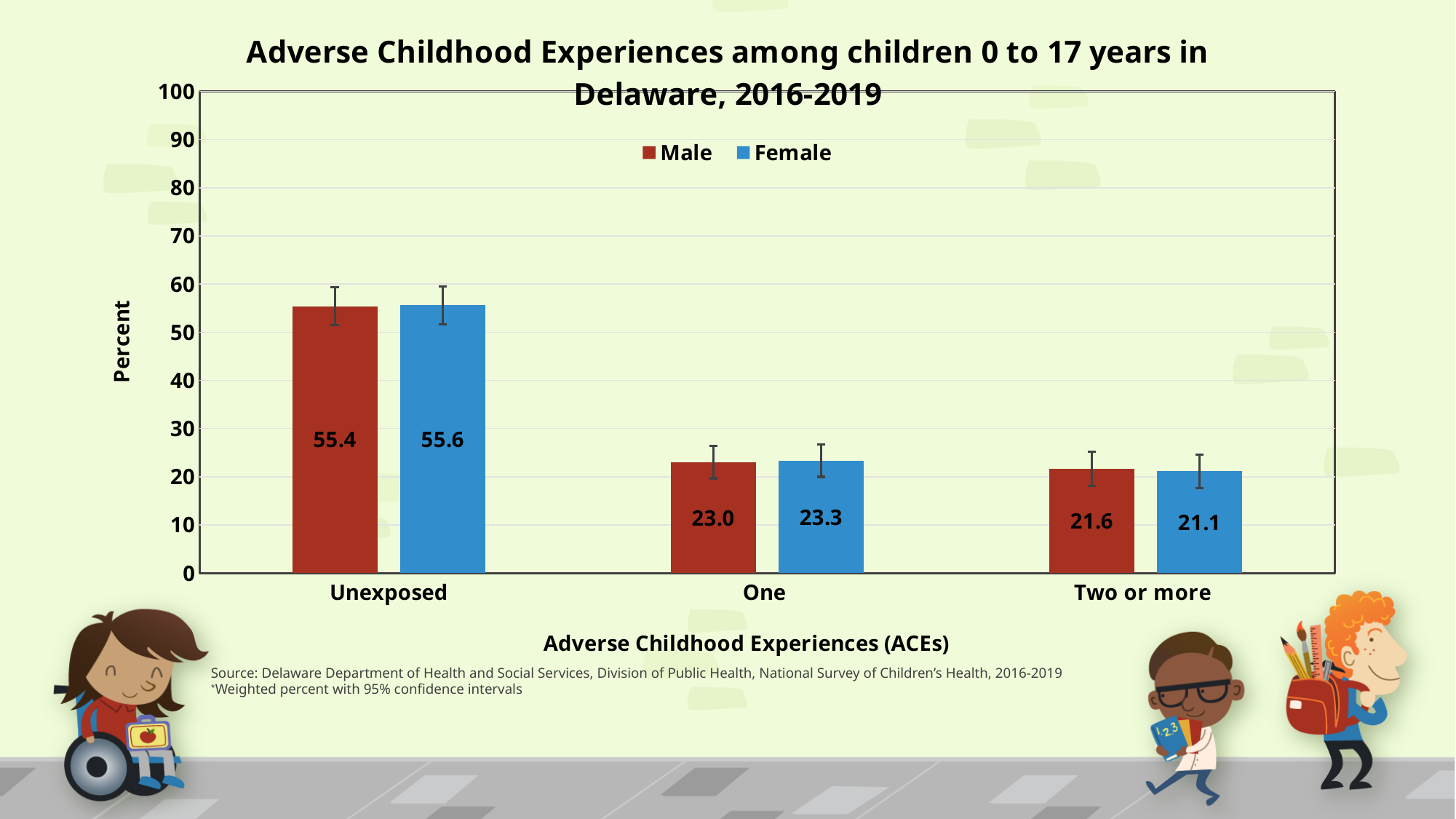
Which category has the highest Female value? Unexposed How many categories are shown on the x axis? 3 What is the label of the y axis? Percent What is the Male value for the Unexposed category? 55.4 Is the Male value for Unexposed greater or less than 50? greater Which category has the lowest Male value? Two or more What is the Female value for the One category? 23.3 What is the Male value for the Two or more category? 21.6 What is the Female value for the Two or more category? 21.1 What kind of chart is shown on the slide? bar chart What is the difference between the Male values for Unexposed and One? 32.4 How many series does the legend list? 2